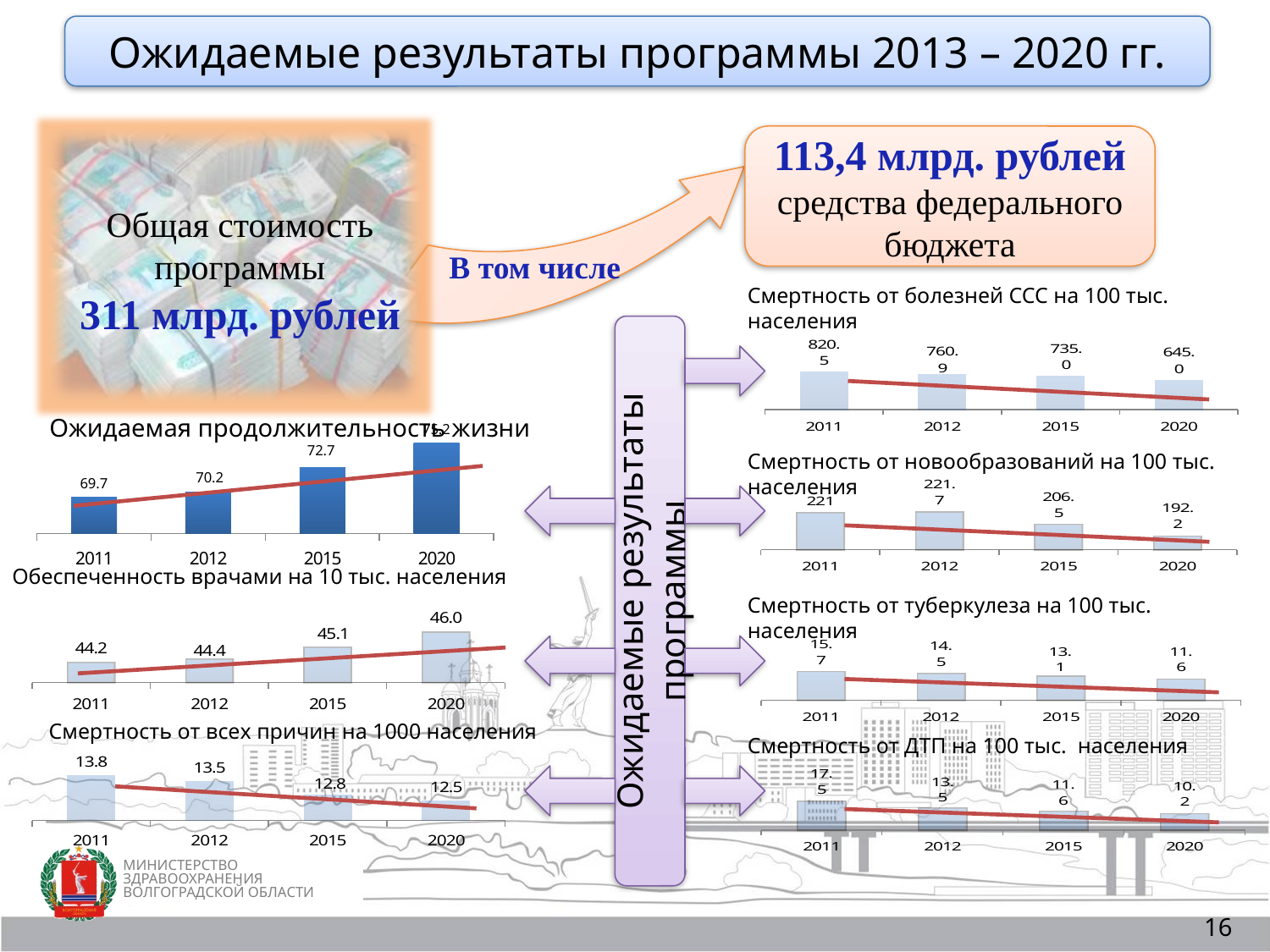
In the chart 'Смертность от новообразований на 100 тыс. населения', which year has the lowest value? 2020 In the chart 'Смертность от всех причин на 1000 населения', do the values rise or fall from 2011 to 2020? fall In the chart 'Смертность от болезней ССС на 100 тыс. населения', what is the value for 2020? 645.0 How many years are shown on the x axis of the chart 'Смертность от туберкулеза на 100 тыс. населения'? 4 In the chart 'Обеспеченность врачами на 10 тыс. населения', what is the value for 2020? 46.0 In the chart 'Смертность от ДТП на 100 тыс. населения', what is the difference between the values for 2011 and 2020? 7.3 In the chart 'Ожидаемая продолжительность жизни', what is the difference between the values for 2015 and 2011? 3.0 In the chart 'Смертность от ДТП на 100 тыс. населения', which year has the highest value? 2011 In the chart 'Смертность от туберкулеза на 100 тыс. населения', what is the value for 2015? 13.1 In the chart 'Смертность от болезней ССС на 100 тыс. населения', which is larger, the value for 2012 or the value for 2015? 2012 What kind of chart is 'Обеспеченность врачами на 10 тыс. населения'? bar chart In the chart 'Смертность от всех причин на 1000 населения', what is the value for 2011? 13.8